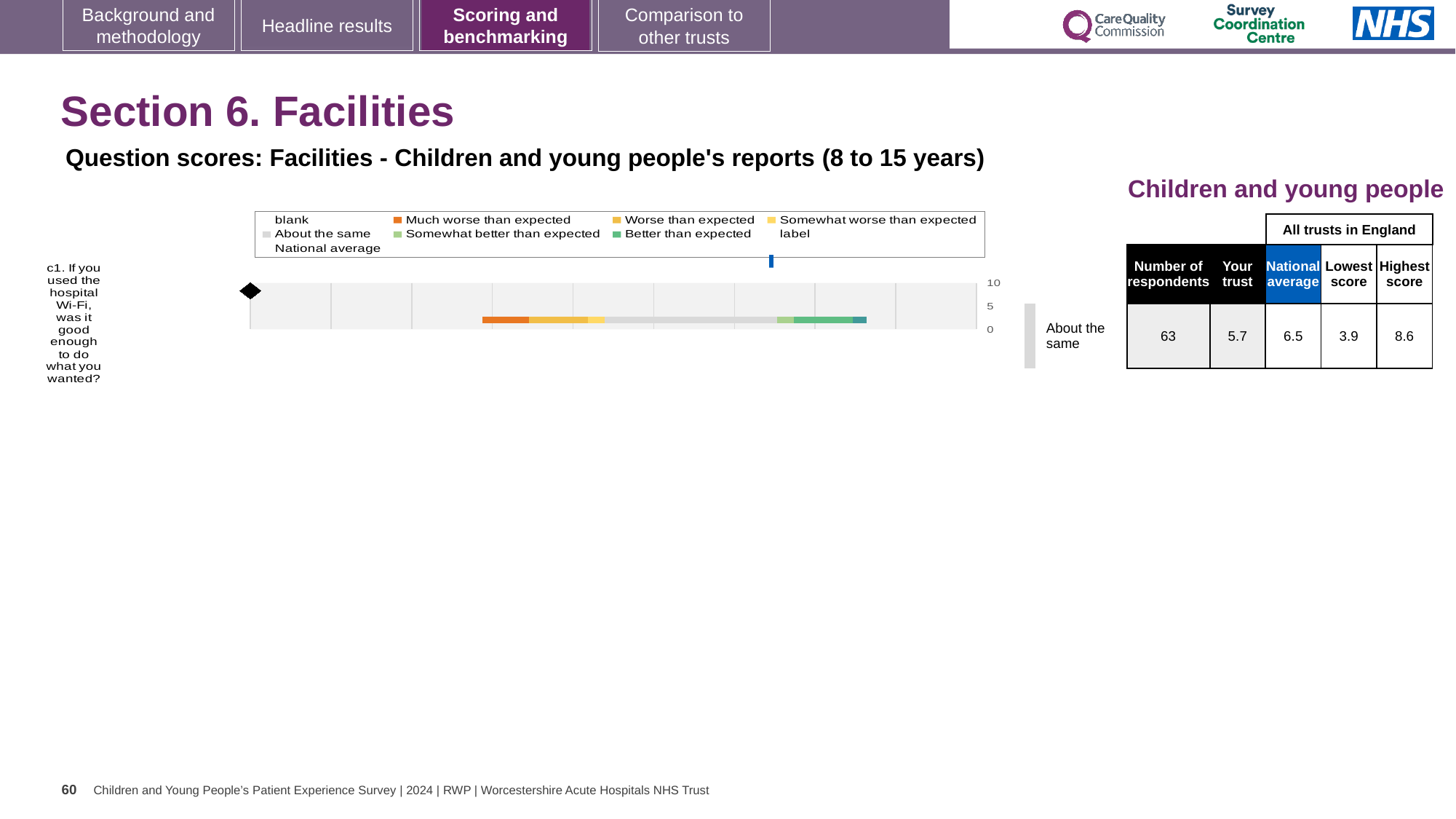
According to the table next to the chart, what is the national average for question c1? 6.5 Which question is plotted in the chart? c1. If you used the hospital Wi-Fi, was it good enough to do what you wanted? Which is larger for question c1: the trust's score or the national average? national average According to the table next to the chart, how many respondents answered question c1? 63 What is the highest value shown on the chart's axis? 10 According to the table next to the chart, what is the lowest score among all trusts in England for question c1? 3.9 What colour does the legend use for 'Much worse than expected'? orange How many questions (categories) are plotted in the chart? 1 According to the table next to the chart, what is the 'Your trust' score for question c1? 5.7 What kind of chart is shown on the slide? bar chart What is the difference between the highest score and the lowest score for question c1 in the table? 4.7 According to the table next to the chart, what is the highest score among all trusts in England for question c1? 8.6